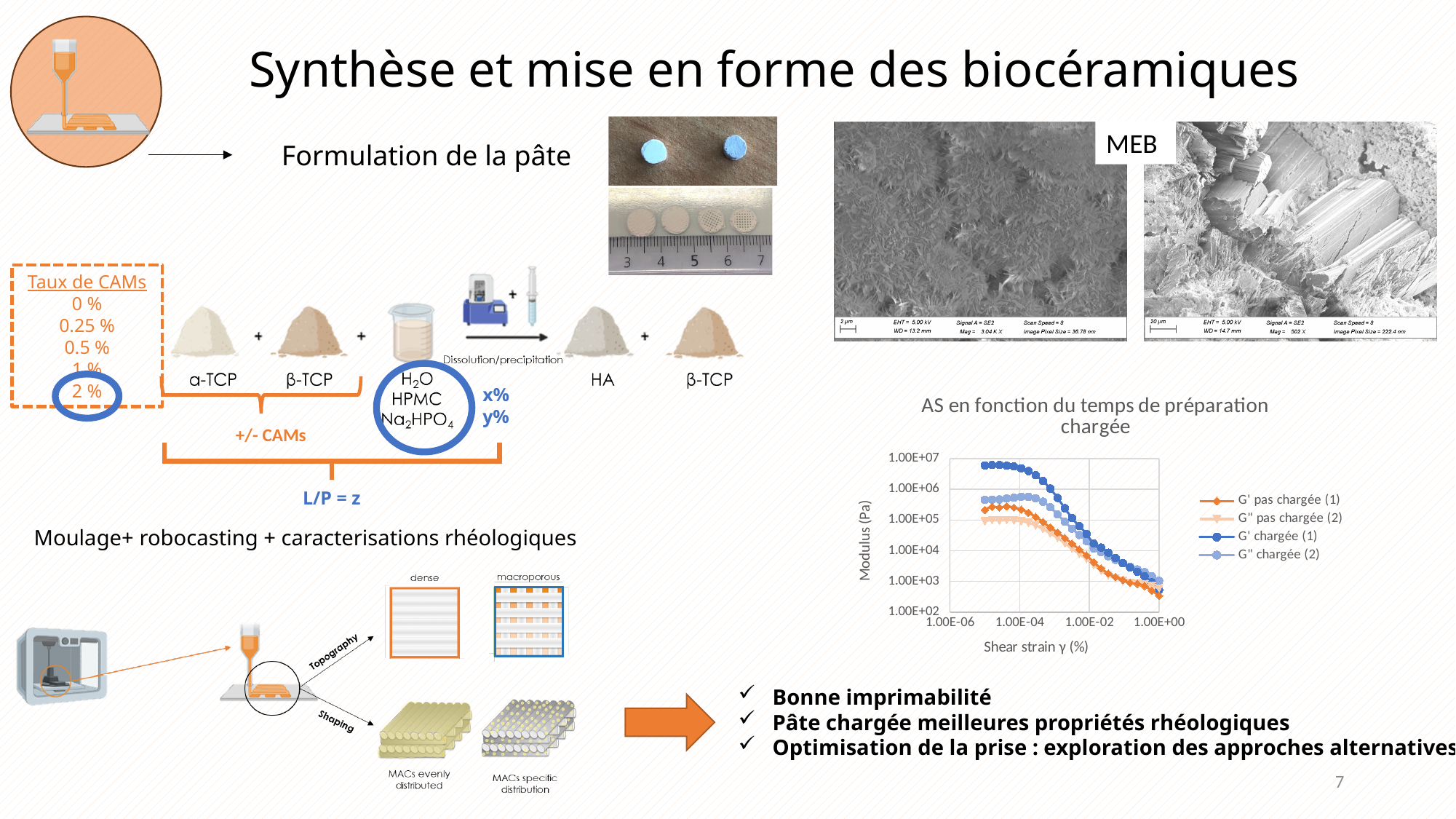
What is the title of the chart on the slide? AS en fonction du temps de préparation chargée How many series does the chart legend list? 4 Which series has the highest modulus at the lowest shear strain values? G' chargée (1) Which series has the lowest modulus at the lowest shear strain values? G" pas chargée (2) At the highest shear strain values, is the modulus of G' pas chargée (1) greater or less than 1.00E+04 Pa? less At low shear strain, is the modulus of G' chargée (1) greater or less than 1.00E+06 Pa? greater What kind of chart is shown on the slide? line chart Do the modulus values rise or fall as shear strain increases along the x axis? fall At low shear strain, which series has the larger modulus: G' chargée (1) or G' pas chargée (1)? G' chargée (1) What is the lowest tick value shown on the y axis of the chart? 1.00E+02 What is the label of the x axis of the chart? Shear strain γ (%) At low shear strain, is the modulus of G' pas chargée (1) greater or less than 1.00E+06 Pa? less